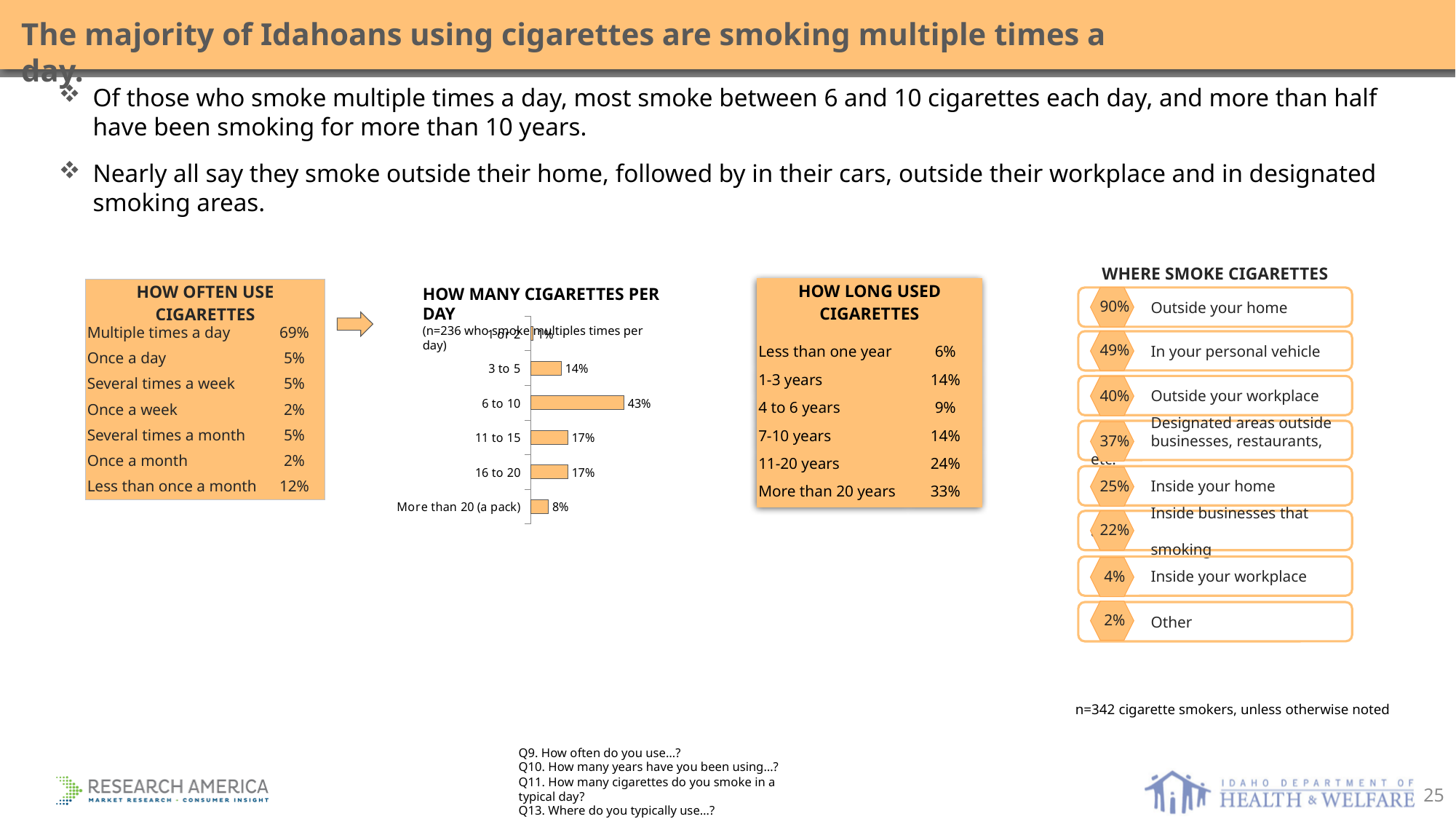
In the 'HOW MANY CIGARETTES PER DAY' chart, what is the difference between the values for 16 to 20 and More than 20 (a pack)? 9% In the 'HOW MANY CIGARETTES PER DAY' chart, what is the difference between the values for 6 to 10 and 3 to 5? 29% What kind of chart is 'HOW MANY CIGARETTES PER DAY'? Bar chart In the 'HOW MANY CIGARETTES PER DAY' chart, which is larger: the value for 3 to 5 or the value for More than 20 (a pack)? 3 to 5 In the 'HOW MANY CIGARETTES PER DAY' chart, what is the value for More than 20 (a pack)? 8% In the 'HOW MANY CIGARETTES PER DAY' chart, do 11 to 15 and 16 to 20 have the same value? Yes, both 17% How many categories are shown in the 'HOW MANY CIGARETTES PER DAY' chart? 6 What sample size is noted under the 'HOW MANY CIGARETTES PER DAY' chart title? n=236 who smoke multiples times per day In the 'HOW MANY CIGARETTES PER DAY' chart, what is the value for 11 to 15? 17% In the 'HOW MANY CIGARETTES PER DAY' chart, which category has the highest value? 6 to 10 In the 'HOW MANY CIGARETTES PER DAY' chart, what is the value for 3 to 5? 14% In the 'HOW MANY CIGARETTES PER DAY' chart, what percentage smoke 6 to 10 cigarettes per day? 43%